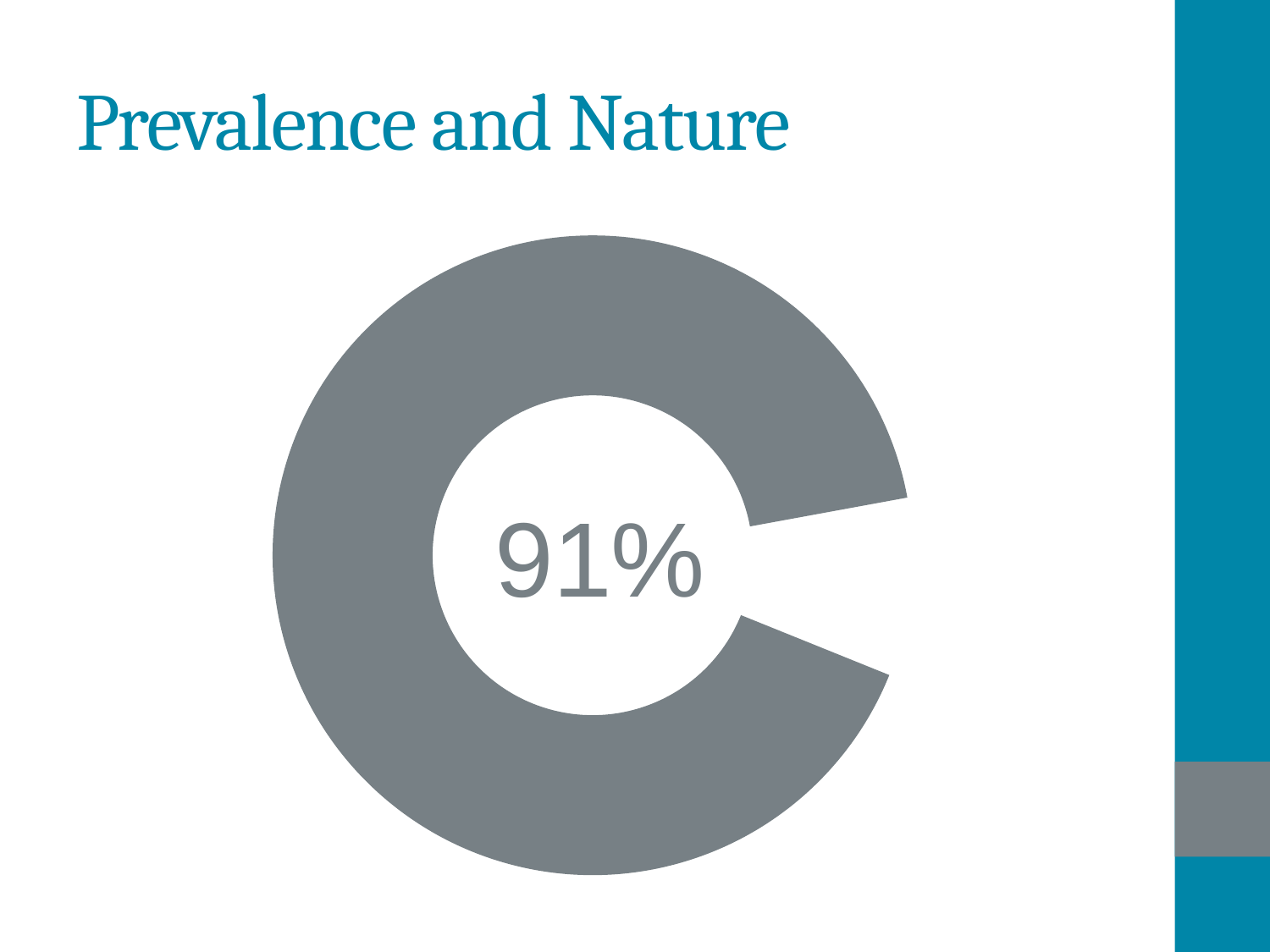
What share of the doughnut chart is left uncovered by the grey segment? 9% What kind of chart is shown on the slide? doughnut chart What share of the doughnut chart does the grey segment represent? 91% What colour is the filled segment of the doughnut chart? grey Is the value shown in the doughnut chart greater or less than 50%? greater What is the title of the slide containing the doughnut chart? Prevalence and Nature Is the grey segment of the doughnut chart larger or smaller than the remaining gap? larger What percentage value is printed in the centre of the doughnut chart? 91%